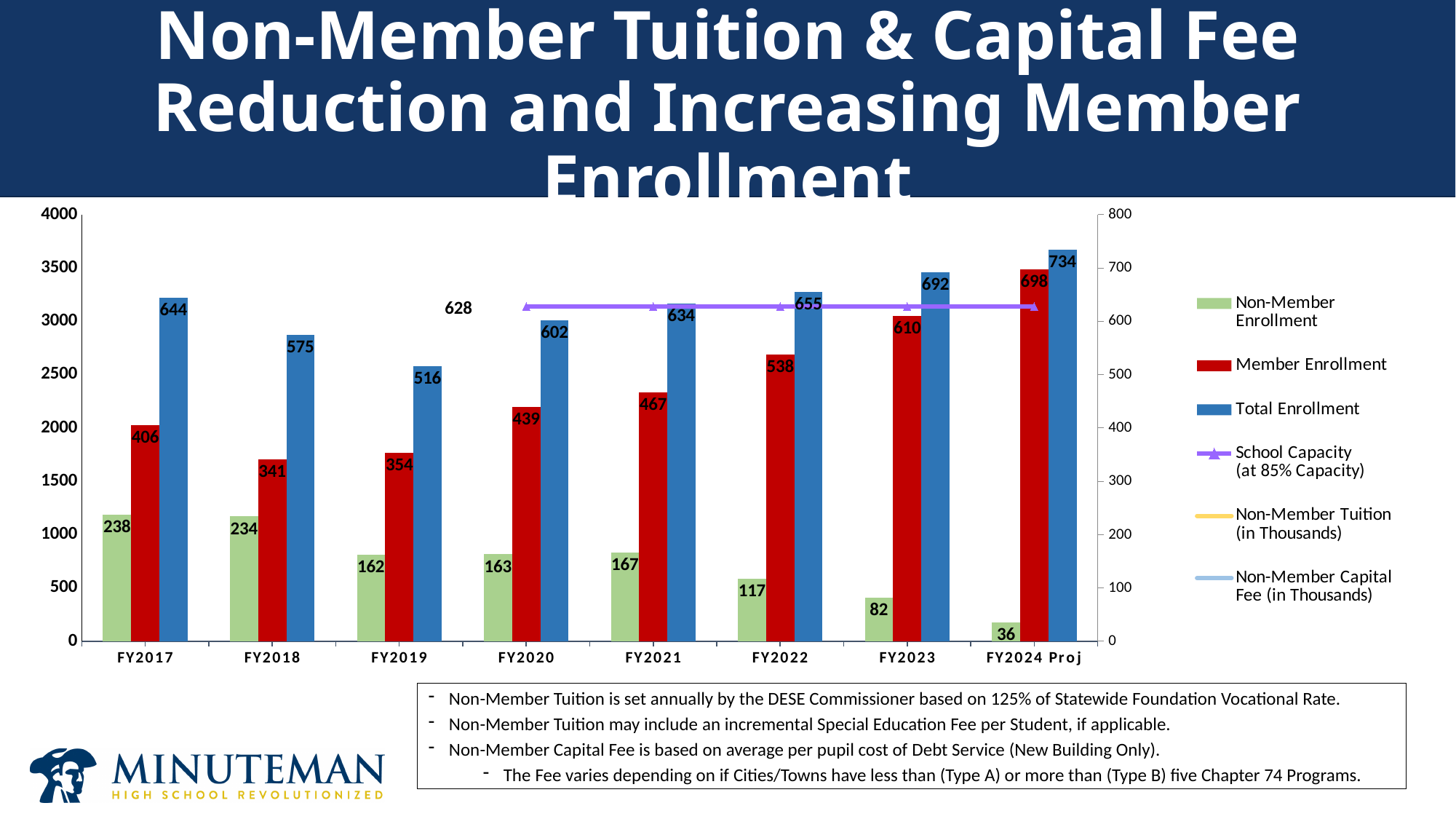
Which is larger, Non-Member Enrollment in FY2018 or in FY2022? FY2018 How many fiscal years are shown on the x axis? 8 What value is labelled on the School Capacity (at 85% Capacity) line? 628 What is the Member Enrollment value for FY2021? 467 How many series does the legend list? 6 What kind of chart is used to show the enrollment figures? Bar chart Which fiscal year has the lowest Total Enrollment? FY2019 What is the Total Enrollment value for FY2024 Proj? 734 What is the difference between Member Enrollment in FY2024 Proj and FY2017? 292 Which fiscal year has the highest Non-Member Enrollment? FY2017 What is the Non-Member Enrollment value for FY2019? 162 Does Member Enrollment rise or fall from FY2018 to FY2024 Proj? Rise